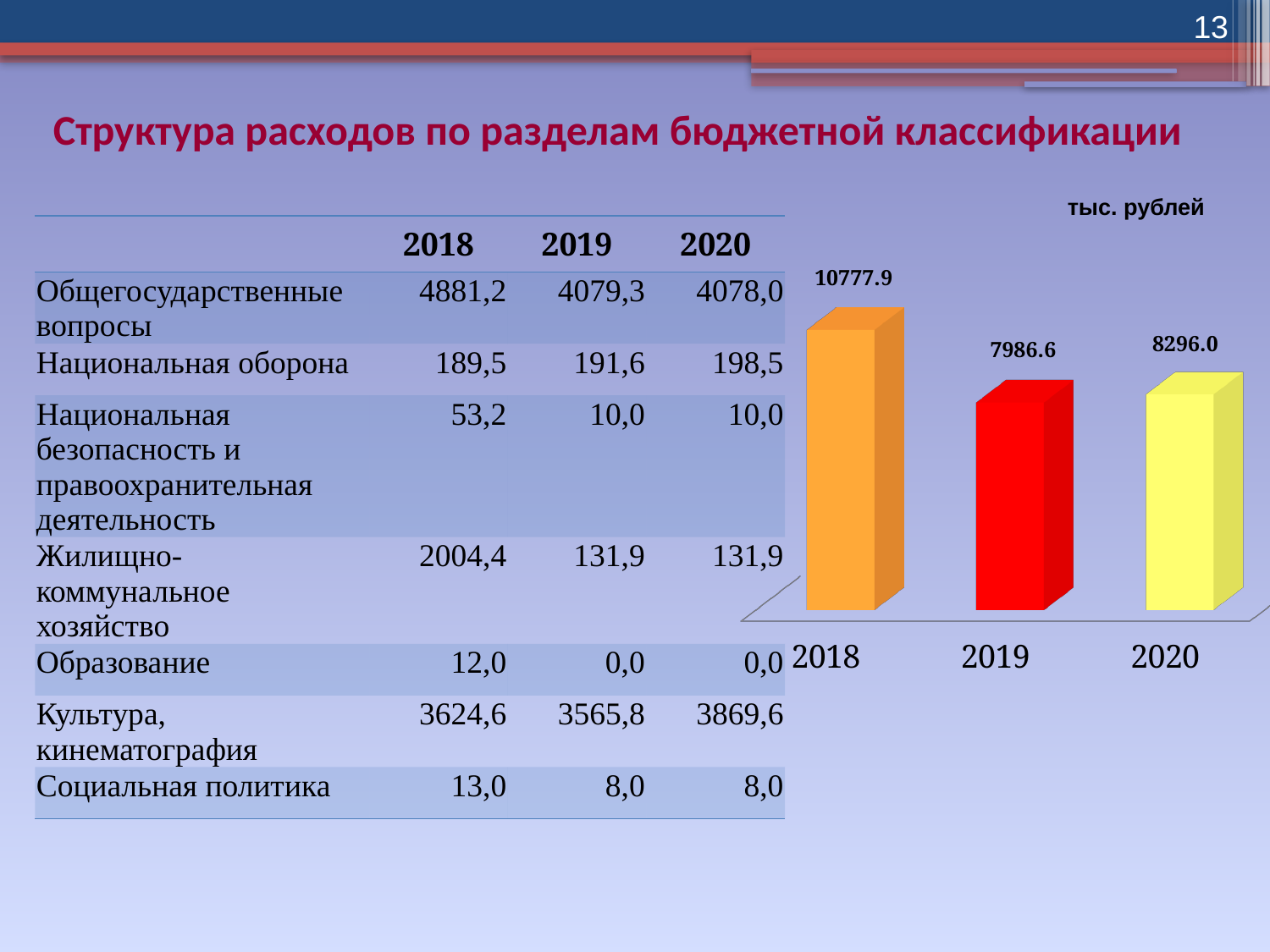
Which year has the lowest value on the bar chart? 2019 Which year has the highest value on the bar chart? 2018 What value is shown for 2020 on the bar chart? 8296.0 On the bar chart, what is the difference between the 2018 value and the 2019 value? 2791.3 What unit is indicated above the bar chart? тыс. рублей What value is shown for 2018 on the bar chart? 10777.9 What type of chart is shown on the slide? bar chart On the bar chart, which is larger: the value for 2019 or the value for 2020? 2020 On the bar chart, do the values rise or fall from 2019 to 2020? rise How many bars are plotted on the chart? 3 On the bar chart, what is the difference between the 2020 value and the 2019 value? 309.4 What value is shown for 2019 on the bar chart? 7986.6